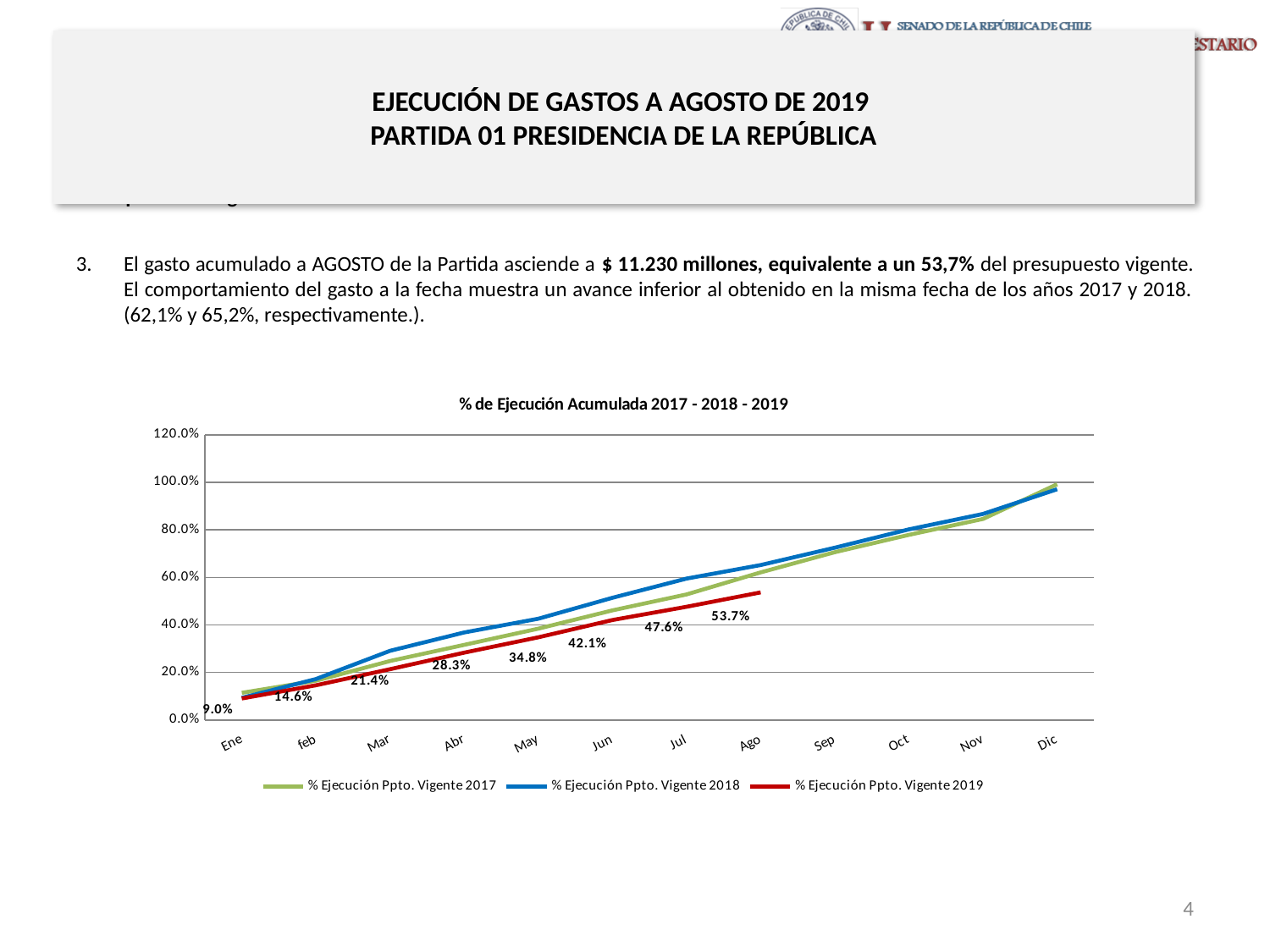
What is the difference between the 2019 values for Ago and Jul? 6.1% What is the title of the chart? % de Ejecución Acumulada 2017 - 2018 - 2019 Is the value for % Ejecución Ppto. Vigente 2018 in Ago greater or less than 60.0%? greater What is the value of % Ejecución Ppto. Vigente 2019 for Ago? 53.7% What is the value of % Ejecución Ppto. Vigente 2019 for Ene? 9.0% How many series does the legend of the chart list? 3 How many months are shown on the x axis of the chart? 12 In Ago, which series has the larger value: % Ejecución Ppto. Vigente 2018 or % Ejecución Ppto. Vigente 2019? % Ejecución Ppto. Vigente 2018 Which month has the highest value for % Ejecución Ppto. Vigente 2019? Ago What kind of chart is shown on the slide? line chart What is the value of % Ejecución Ppto. Vigente 2019 for May? 34.8% Does the % Ejecución Ppto. Vigente 2019 line rise or fall from Ene to Ago? rise